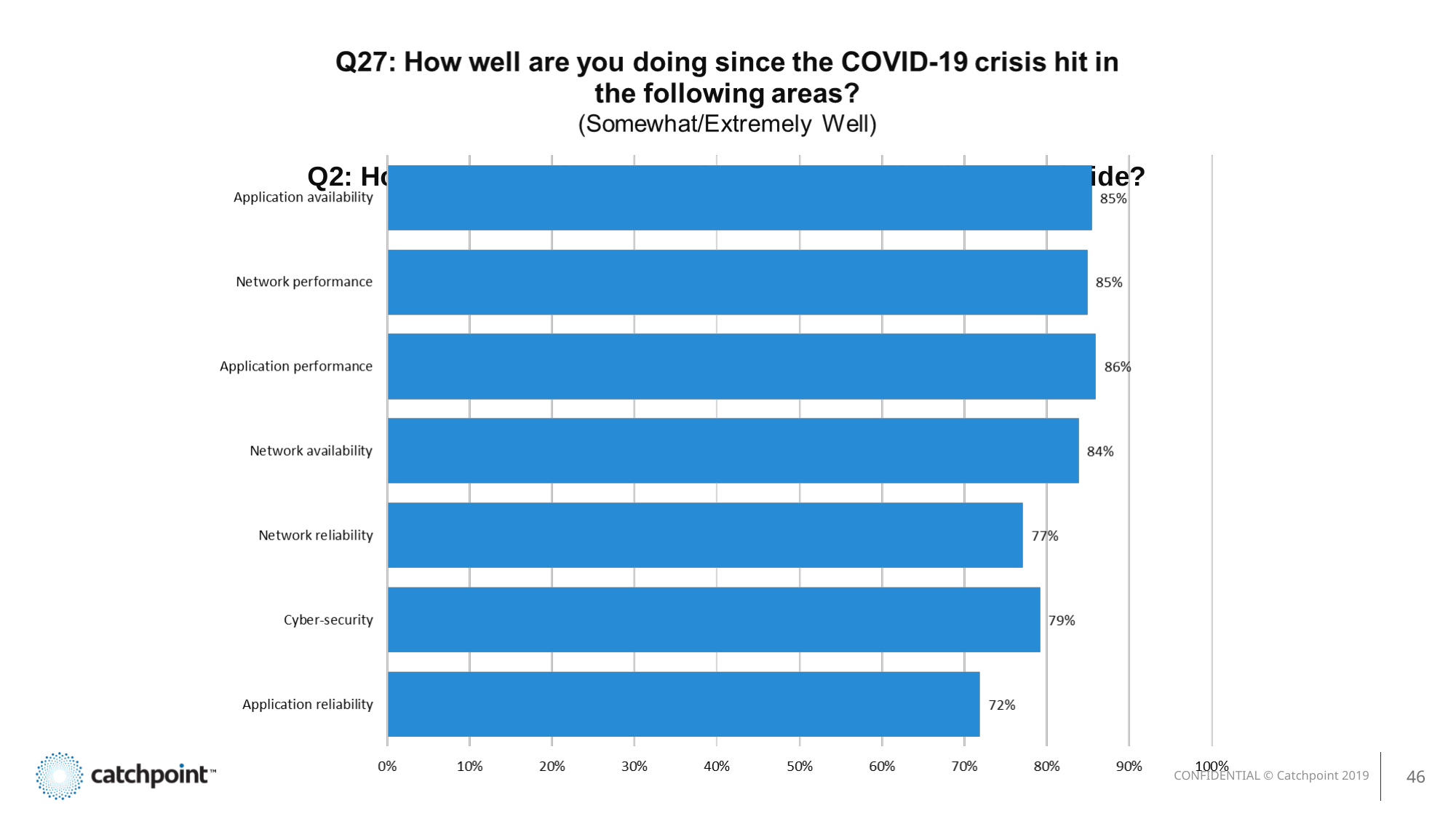
What is the value for Application reliability? 72% Is the value for Network reliability greater or less than 80%? less Which is larger, the value for Network availability or the value for Cyber-security? Network availability Which category has the lowest value? Application reliability What is the difference between the values for Application performance and Application reliability? 14% What is the value for Network reliability? 77% What kind of chart is shown on the slide? Bar chart What is the value for Application performance? 86% What is the value for Cyber-security? 79% Which category has the highest value? Application performance What is the difference between the values for Cyber-security and Network reliability? 2% How many categories are shown in the chart? 7